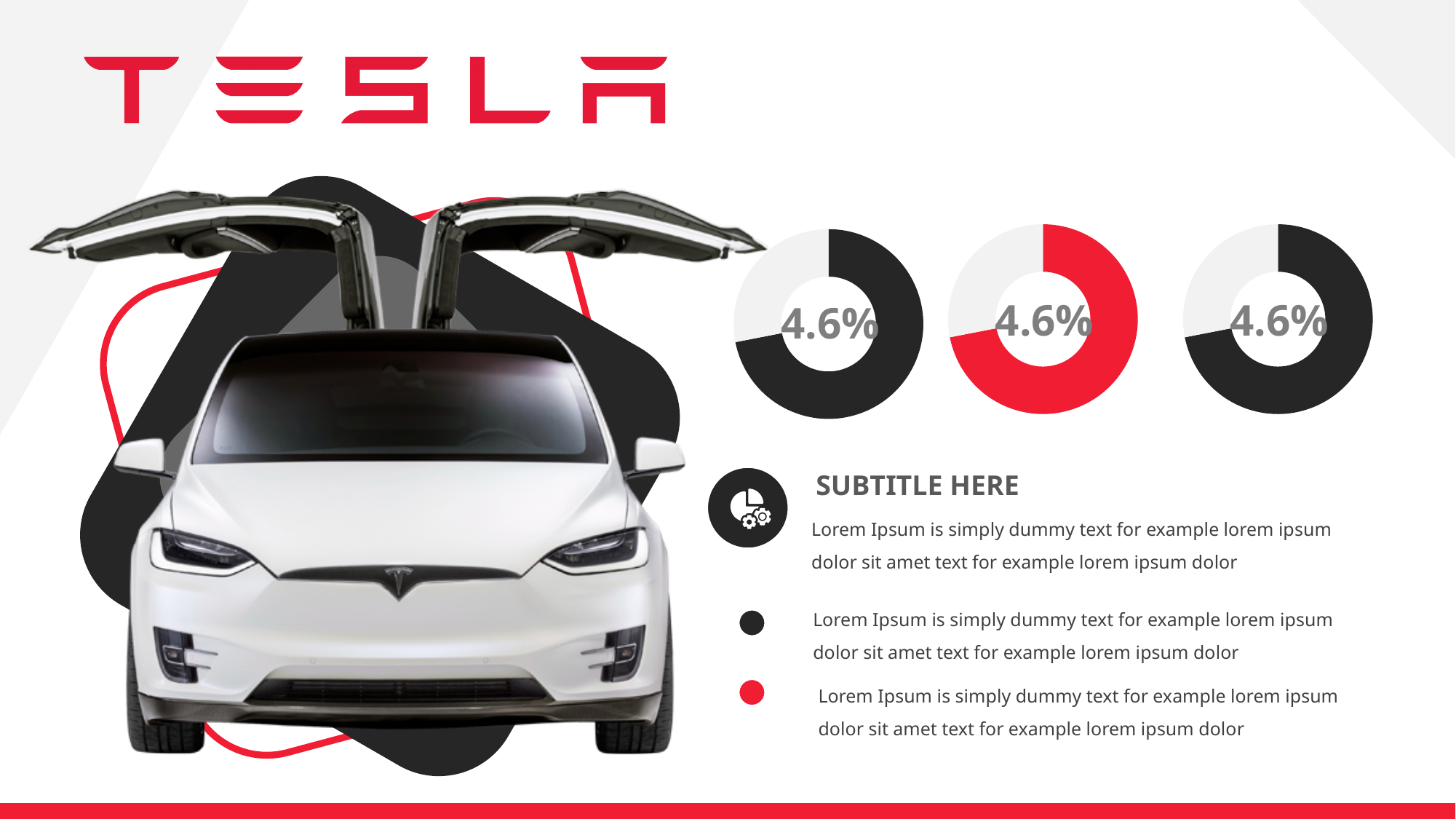
How many donut charts are shown on the slide? 3 What value is printed in the centre of the middle donut chart? 4.6% Do the left and right donut charts show the same printed value? Yes What value is printed in the centre of the left donut chart? 4.6% What kind of chart is used for the three charts on the right side of the slide? Donut (pie) chart What colour is the filled segment of the left donut chart? Black What colour is the filled segment of the middle donut chart? Red What value is printed in the centre of the right donut chart? 4.6%